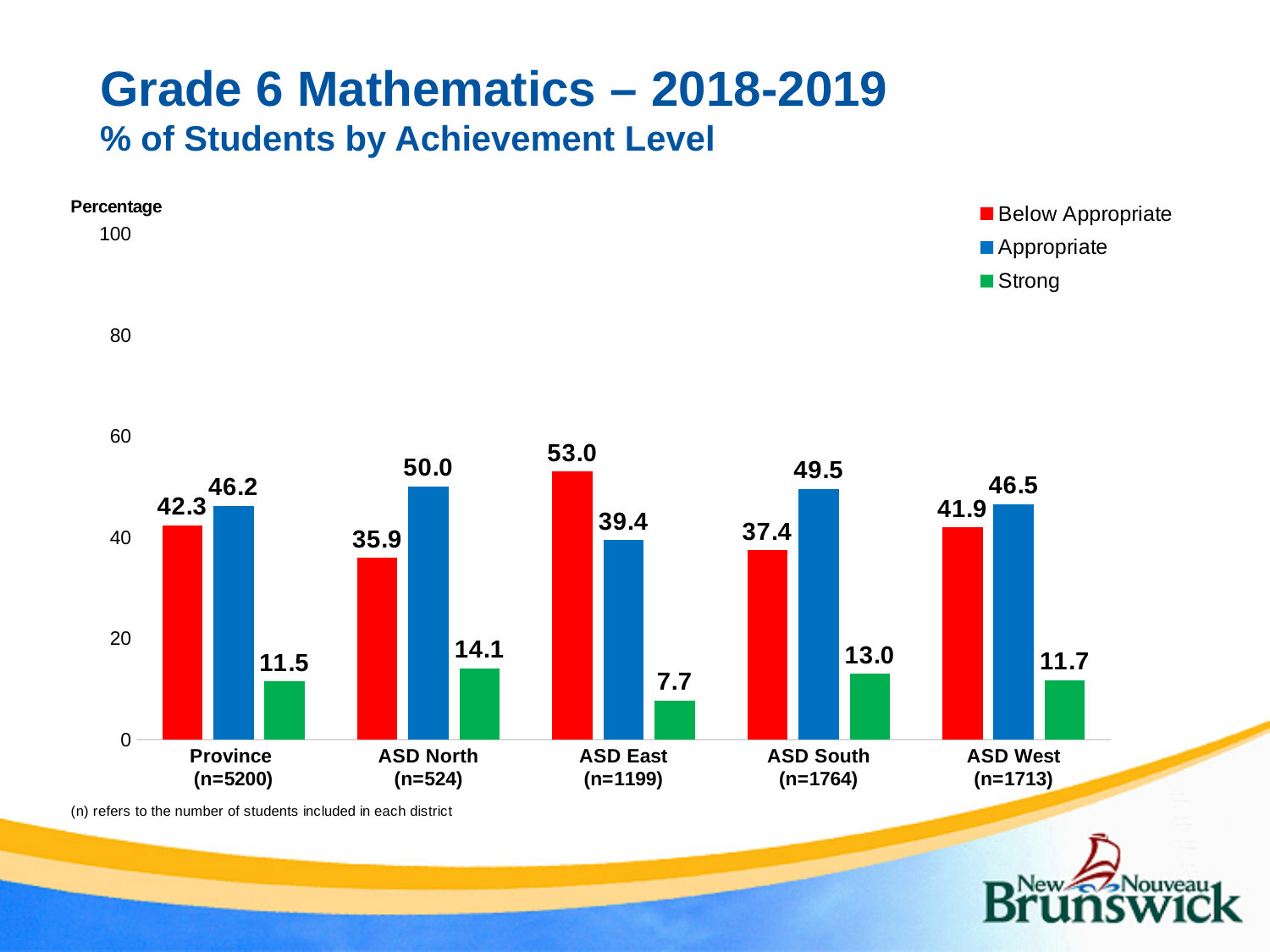
What is the Strong percentage for ASD North? 14.1 Which is larger, the Below Appropriate value for ASD South or for ASD West? ASD West Which category has the lowest Strong percentage? ASD East What is the Appropriate percentage for the Province? 46.2 Which colour represents the Strong series in the legend? green What is the difference between the Appropriate percentages for ASD North and ASD East? 10.6 What is the Below Appropriate percentage for ASD East? 53.0 Which district has the highest Below Appropriate percentage? ASD East Is the Appropriate value for ASD South greater or less than 40? greater What kind of chart is shown on the slide? bar chart How many series does the legend list? 3 How many categories are shown on the x axis? 5